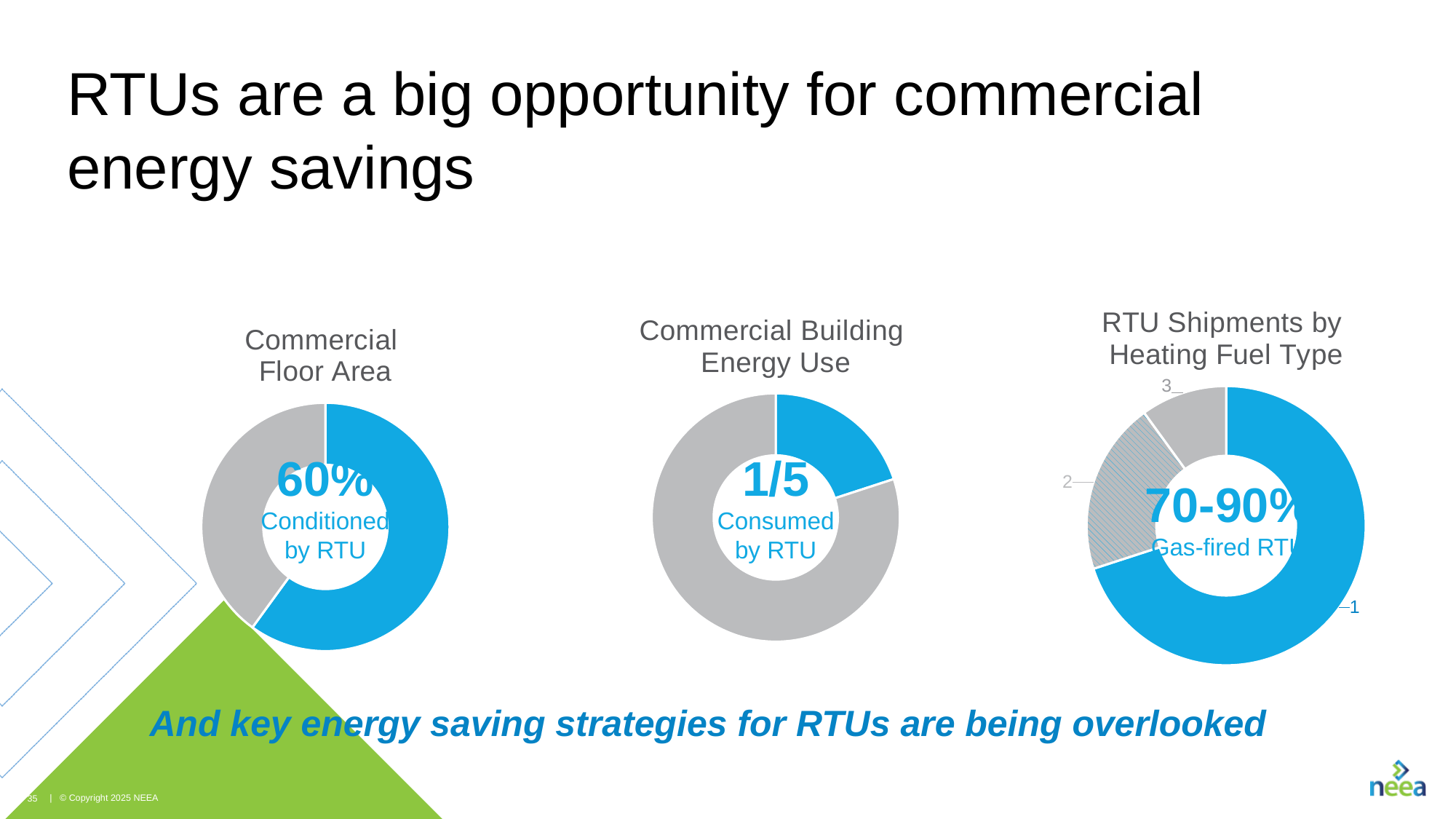
How many slices does the RTU Shipments by Heating Fuel Type chart have? 3 What is the title of the rightmost chart on the slide? RTU Shipments by Heating Fuel Type In the Commercial Building Energy Use chart, is the blue slice larger or smaller than the grey slice? smaller How many charts are shown on the slide? 3 In the Commercial Floor Area chart, is the blue slice larger or smaller than the grey slice? larger How many slices does the Commercial Floor Area chart have? 2 In the RTU Shipments by Heating Fuel Type chart, which numbered slice is the largest? 1 What kind of chart is the Commercial Floor Area chart? doughnut chart In the Commercial Floor Area chart, what share of floor area is conditioned by RTU? 60% In the RTU Shipments by Heating Fuel Type chart, what share of shipments is gas-fired RTU? 70-90% What colour is the slice representing the RTU share in the Commercial Building Energy Use chart? blue In the Commercial Building Energy Use chart, what fraction of energy is consumed by RTU? 1/5